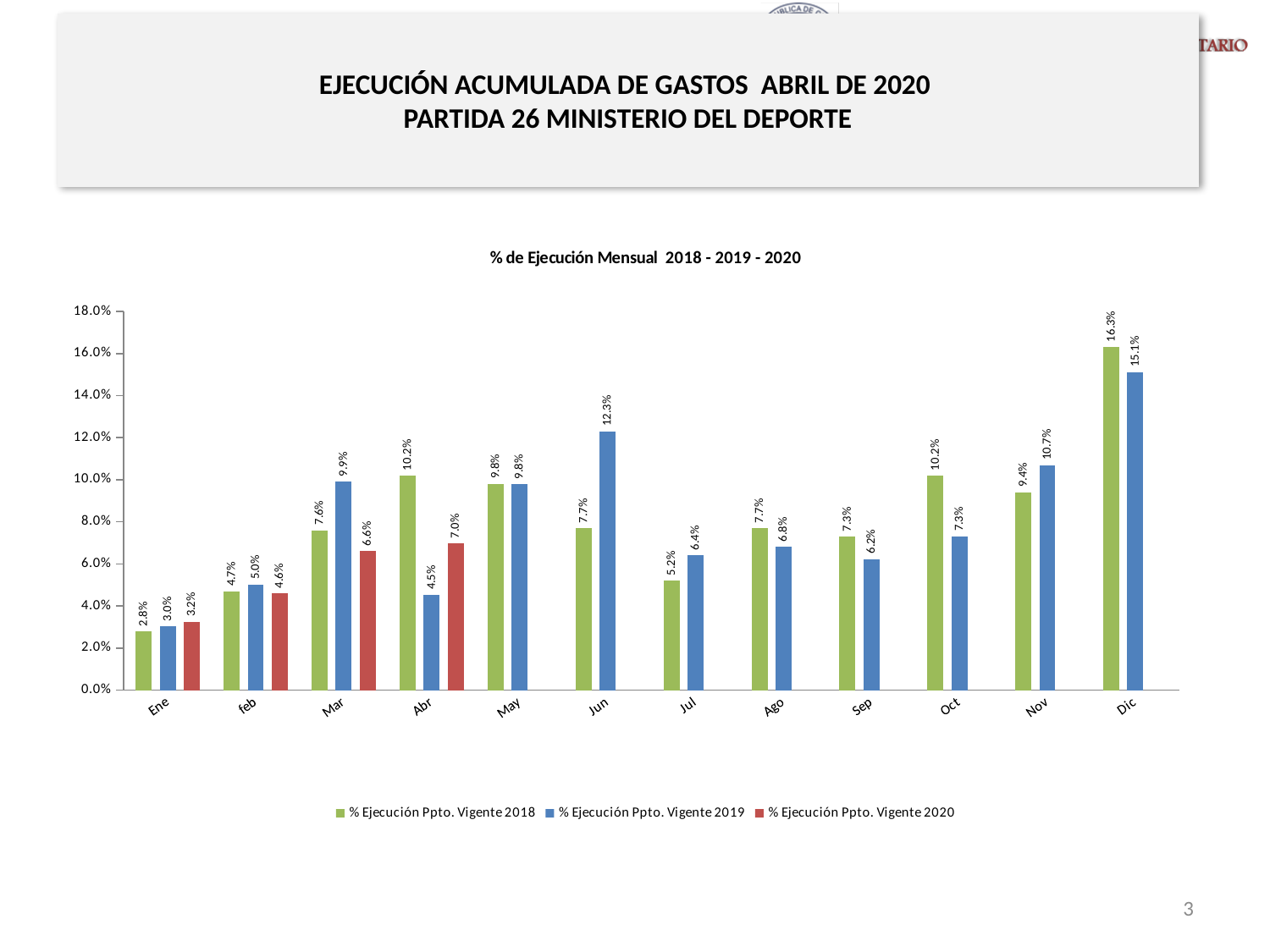
What is the value for % Ejecución Ppto. Vigente 2020 in Abr? 7.0% Which month has the highest value for % Ejecución Ppto. Vigente 2018? Dic What is the value for % Ejecución Ppto. Vigente 2018 in Oct? 10.2% What is the title of the chart? % de Ejecución Mensual 2018 - 2019 - 2020 Which is larger in Abr: the 2018 value or the 2019 value? 2018 value What kind of chart is shown on the slide? Bar chart What is the value for % Ejecución Ppto. Vigente 2019 in Jun? 12.3% How many months are shown on the x axis? 12 What is the difference between the 2018 and 2019 values in Dic? 1.2% Which month has the lowest value for % Ejecución Ppto. Vigente 2019? Ene Is the value for % Ejecución Ppto. Vigente 2019 in Nov greater or less than 10.0%? greater How many series does the legend list? 3